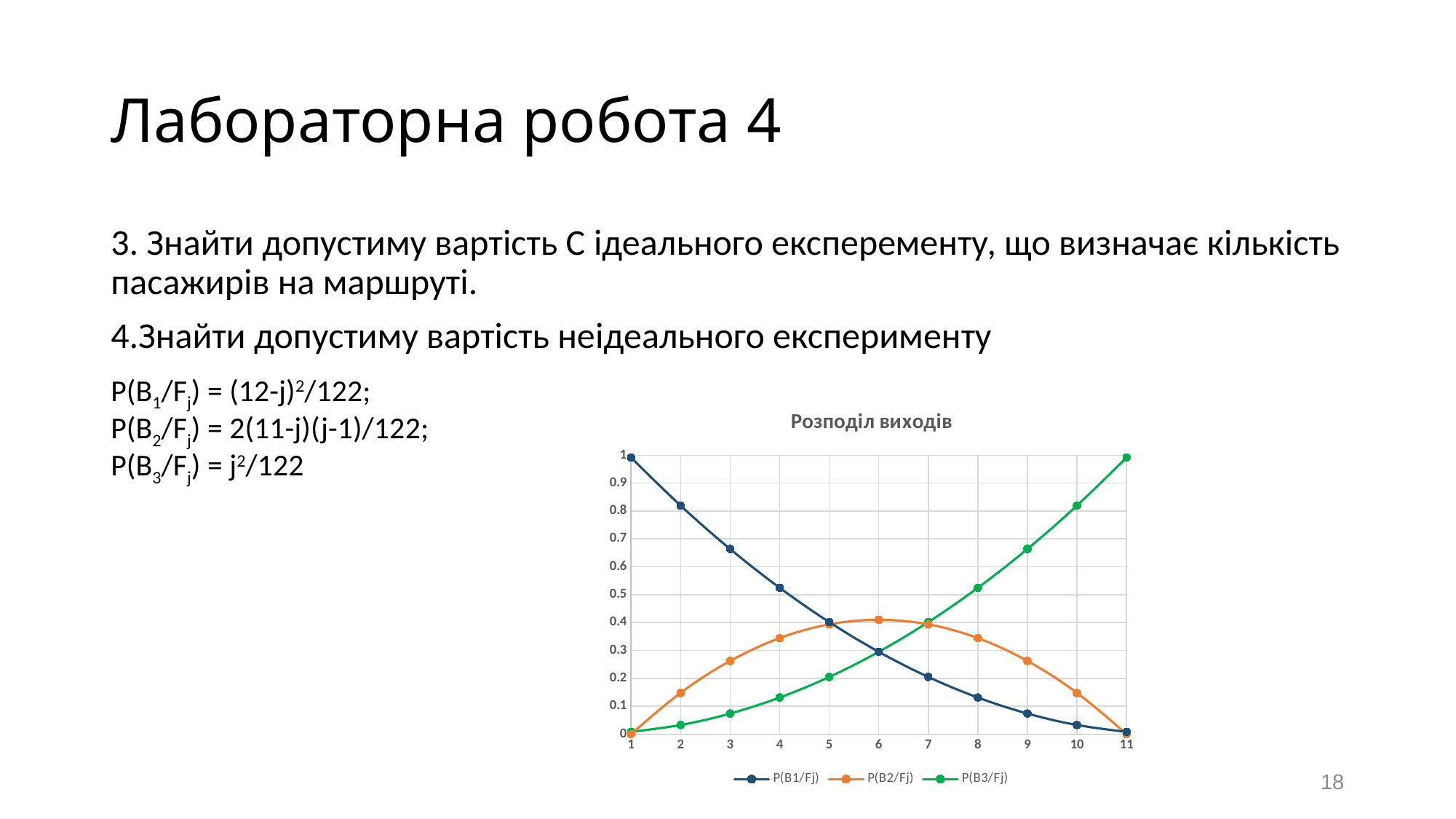
What is the title of the chart? Розподіл виходів How many series does the chart legend list? 3 What is the value of P(B2/Fj) at x = 11? 0 Is the value of P(B1/Fj) at x = 2 greater or less than 0.8? greater What kind of chart is shown on the slide? line chart At which x value does the P(B1/Fj) series reach its highest value? 1 At x = 3, which series has the larger value, P(B1/Fj) or P(B3/Fj)? P(B1/Fj) Does the P(B1/Fj) series rise or fall as x increases from 1 to 11? fall At which x value does the P(B2/Fj) series reach its highest value? 6 How many points are plotted along the x axis for each series? 11 At which x value does the P(B3/Fj) series reach its highest value? 11 What is the value of P(B2/Fj) at x = 1? 0